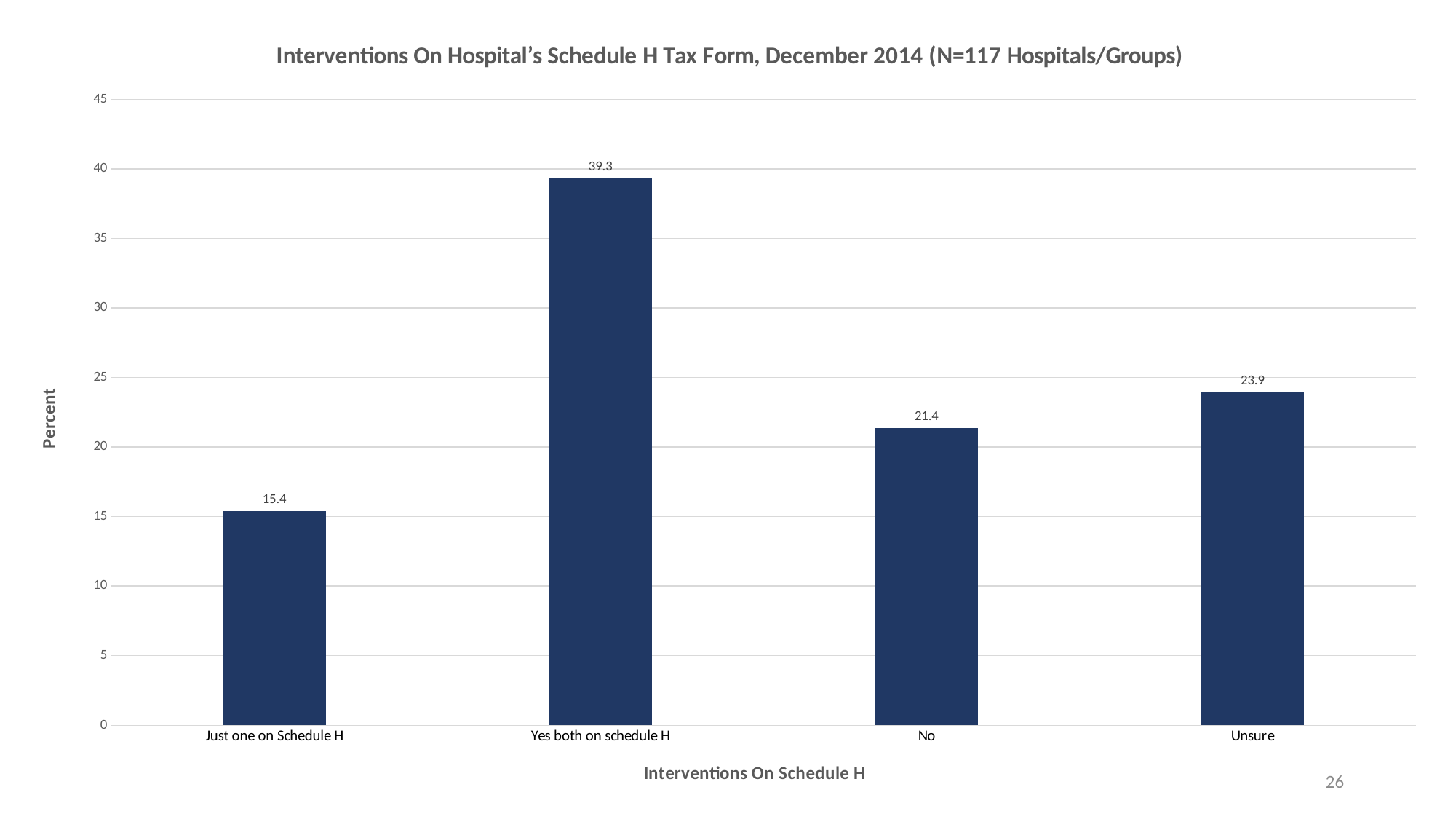
What is the value for "Unsure"? 23.9 Which is larger, the value for "Unsure" or the value for "No"? Unsure What kind of chart is shown on the slide? Bar chart Which category has the highest value? Yes both on schedule H What is the value for "Yes both on schedule H"? 39.3 What is the value for "Just one on Schedule H"? 15.4 What is the value for "No"? 21.4 Which category has the lowest value? Just one on Schedule H Is the value for "No" greater or less than 25? less What is the label of the y axis? Percent What is the difference between the values for "Yes both on schedule H" and "Just one on Schedule H"? 23.9 How many categories are shown on the x axis? 4